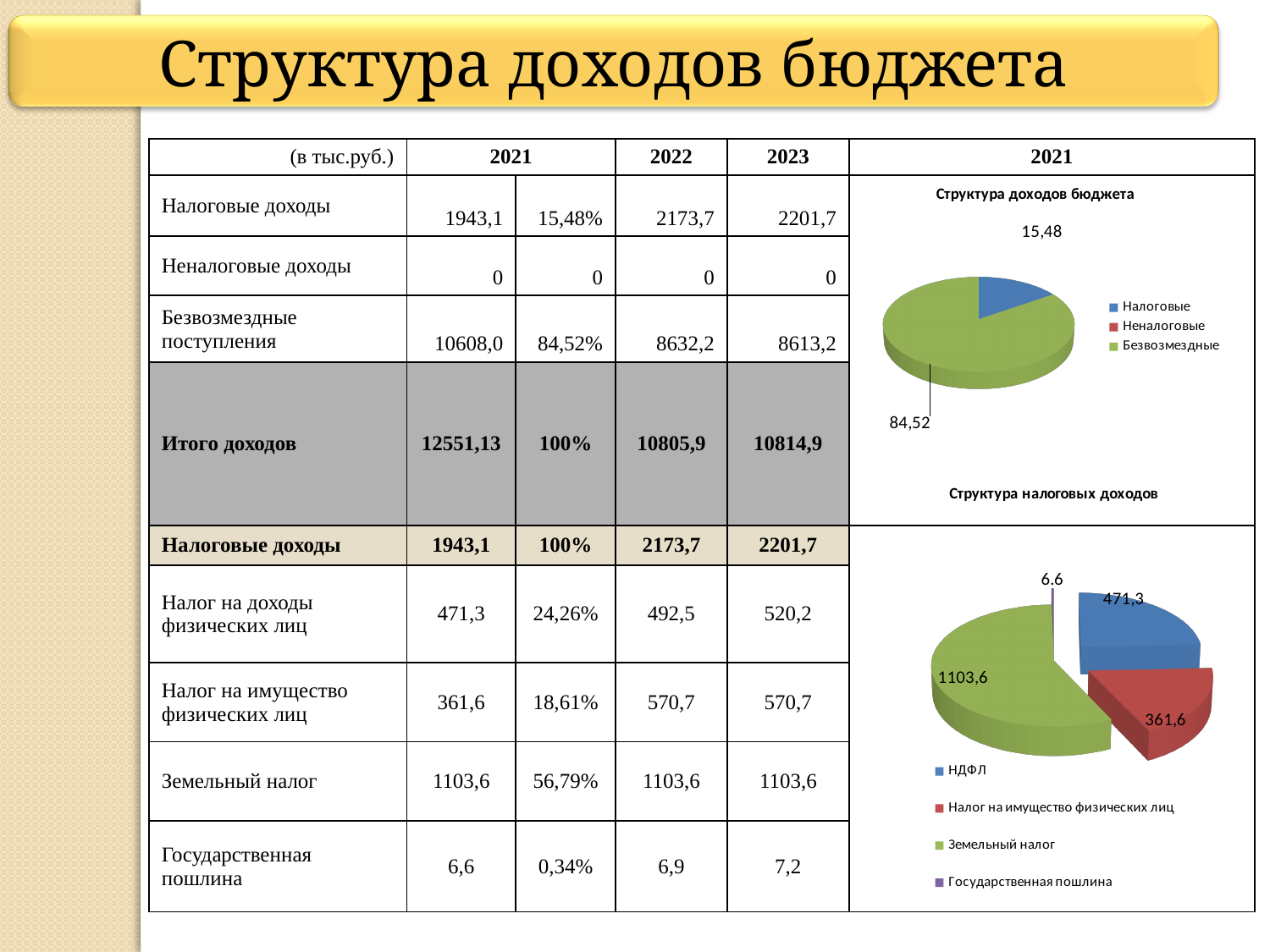
What kind of chart is the top chart titled "Структура доходов бюджета"? pie chart In the bottom chart "Структура налоговых доходов", which slice is the smallest? Государственная пошлина In the bottom chart "Структура налоговых доходов", what value is labelled for Налог на имущество физических лиц? 361,6 In the bottom chart "Структура налоговых доходов", what value is labelled for Государственная пошлина? 6.6 In the top chart "Структура доходов бюджета", what value is labelled on the Налоговые slice? 15,48 In the top chart "Структура доходов бюджета", which slice is the largest? Безвозмездные In the bottom chart "Структура налоговых доходов", what value is labelled for Земельный налог? 1103,6 How many entries does the legend of the bottom chart "Структура налоговых доходов" list? 4 In the bottom chart "Структура налоговых доходов", what value is labelled for НДФЛ? 471,3 How many entries does the legend of the top chart "Структура доходов бюджета" list? 3 In the bottom chart "Структура налоговых доходов", what is the difference between the НДФЛ value and the Налог на имущество физических лиц value? 109,7 In the top chart "Структура доходов бюджета", what value is labelled on the Безвозмездные slice? 84,52